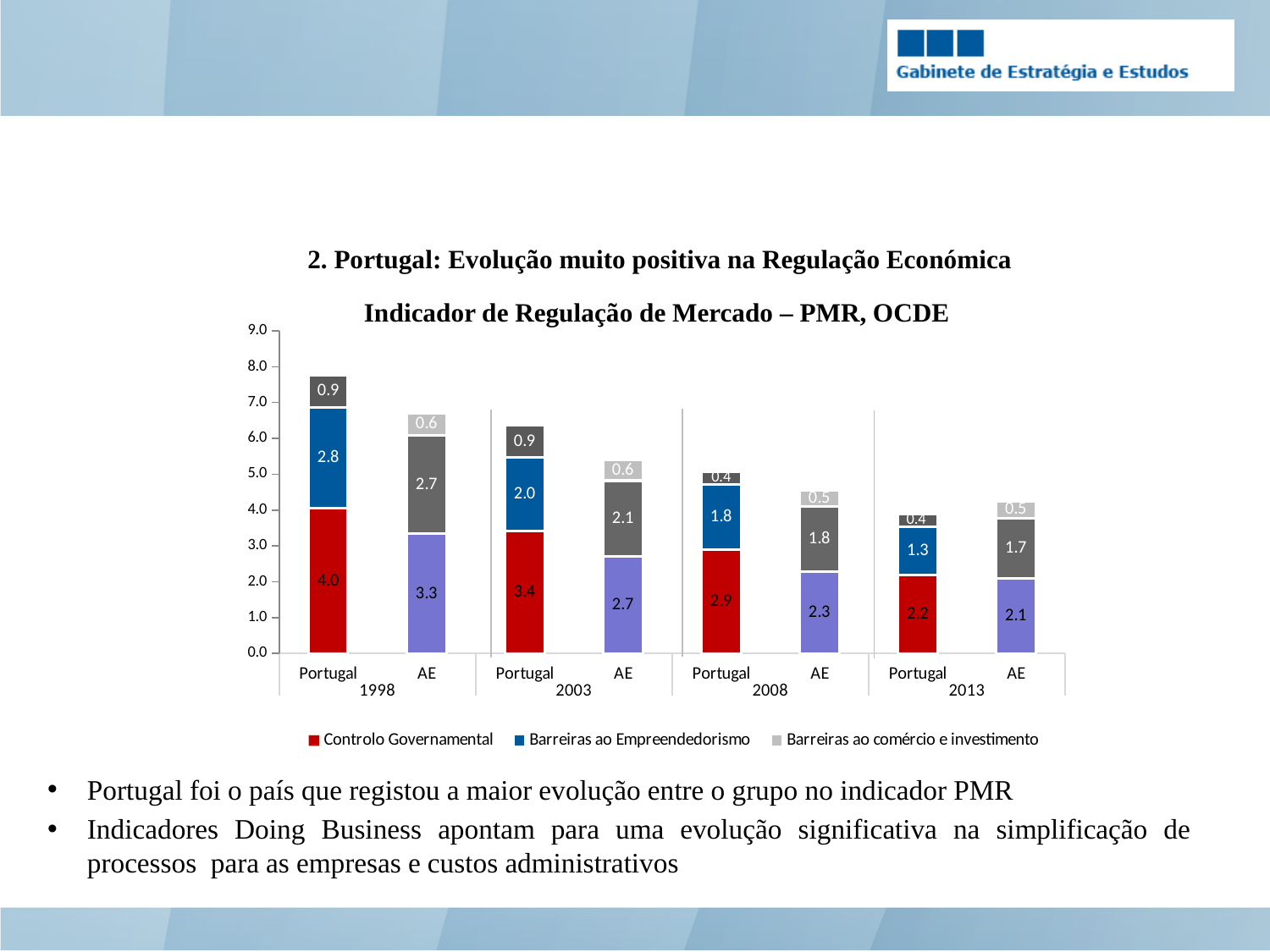
How many series does the chart legend list? 3 How many bars are plotted in the chart? 8 What type of chart is shown on the slide? Stacked bar chart What is the Controlo Governamental value for Portugal in 1998? 4.0 What is the Barreiras ao Empreendedorismo value for AE in 2013? 1.7 Which bar has the highest total value in the chart? Portugal 1998 What is the title of the chart? Indicador de Regulação de Mercado – PMR, OCDE Does the Controlo Governamental value for Portugal rise or fall from 1998 to 2013? Fall What is the difference between the Controlo Governamental values for Portugal in 1998 and Portugal in 2013? 1.8 What is the total of the stacked bar for Portugal in 2013? 3.9 What is the Barreiras ao comércio e investimento value for Portugal in 2003? 0.9 What is the total of the stacked bar for AE in 1998? 6.6